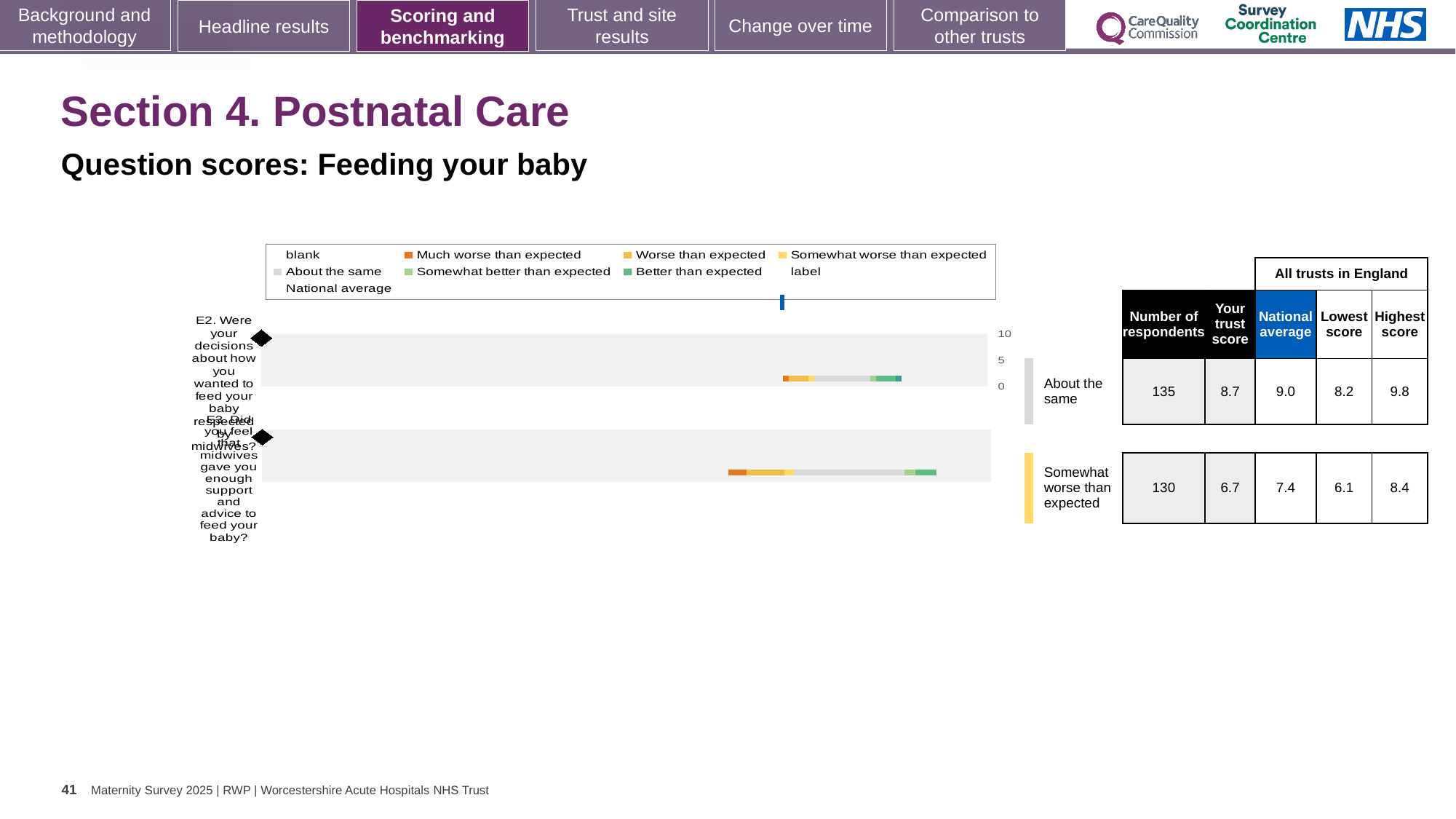
Which benchmark category is the trust score for question E3 placed in? Somewhat worse than expected What is the national average for question E2? 9.0 Which question has the higher trust score, E2 or E3? E2 What is the national average for question E3? 7.4 What is the highest score across all trusts in England for question E2? 9.8 What is the trust score for question E3 (midwives gave enough support and advice to feed your baby)? 6.7 How many questions (categories) are plotted in the chart? 2 What kind of chart is shown on the slide? bar chart What is the lowest score across all trusts in England for question E3? 6.1 What is the difference between the trust score and the national average for question E3? 0.7 What is the trust score for question E2 (decisions about how you wanted to feed your baby respected by midwives)? 8.7 How many respondents answered question E3? 130